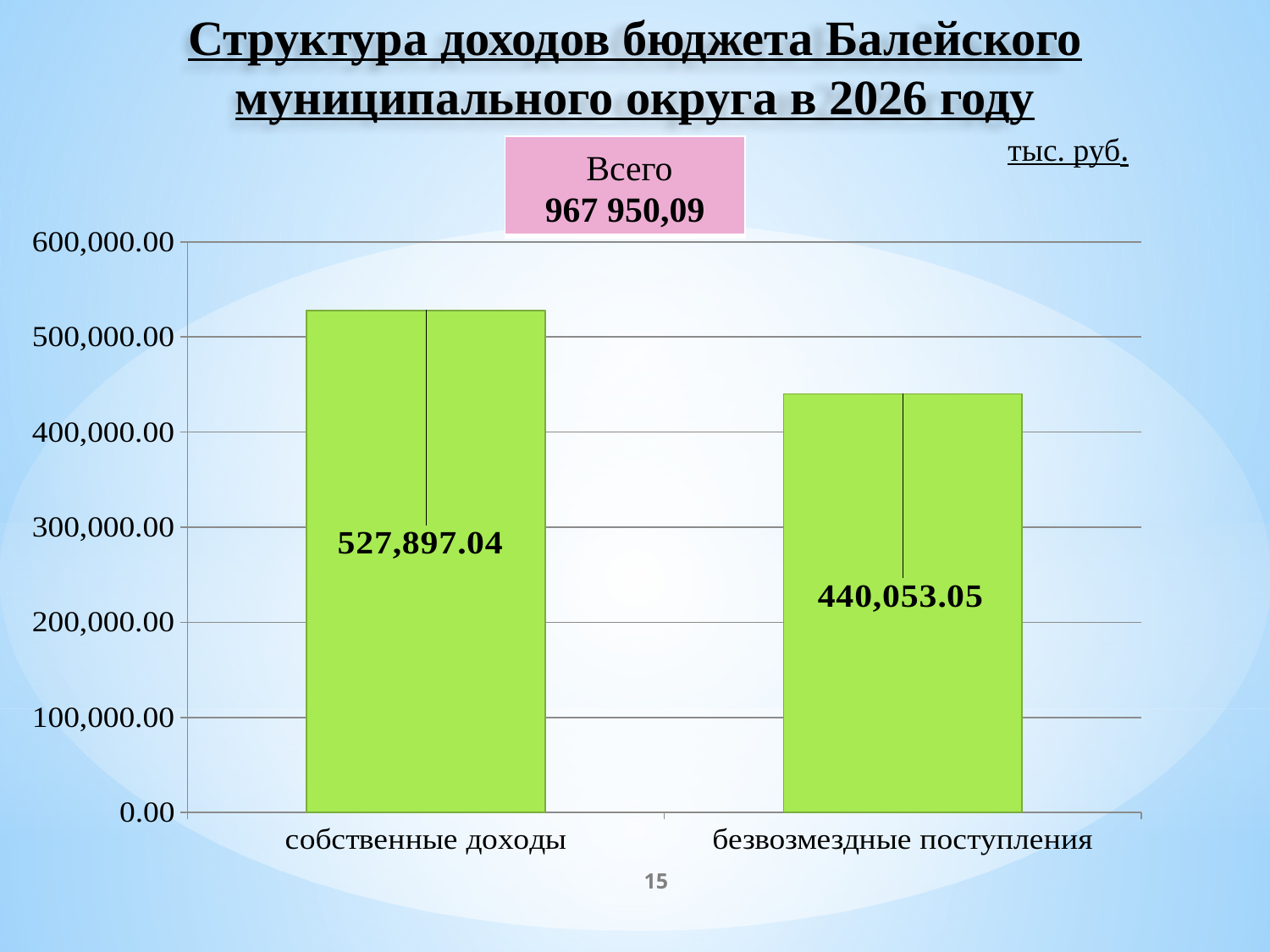
Is the value for собственные доходы greater or less than 500,000.00? greater Which is larger, собственные доходы or безвозмездные поступления? собственные доходы Which category has the highest value? собственные доходы What is the value for собственные доходы? 527,897.04 Is the value for безвозмездные поступления greater or less than 500,000.00? less What kind of chart is shown on the slide? bar chart What is the value for безвозмездные поступления? 440,053.05 How many categories are shown in the chart? 2 What unit is indicated for the values on the slide? тыс. руб. What total (Всего) is shown above the chart? 967 950,09 What is the difference between собственные доходы and безвозмездные поступления? 87,843.99 Which category has the lowest value? безвозмездные поступления